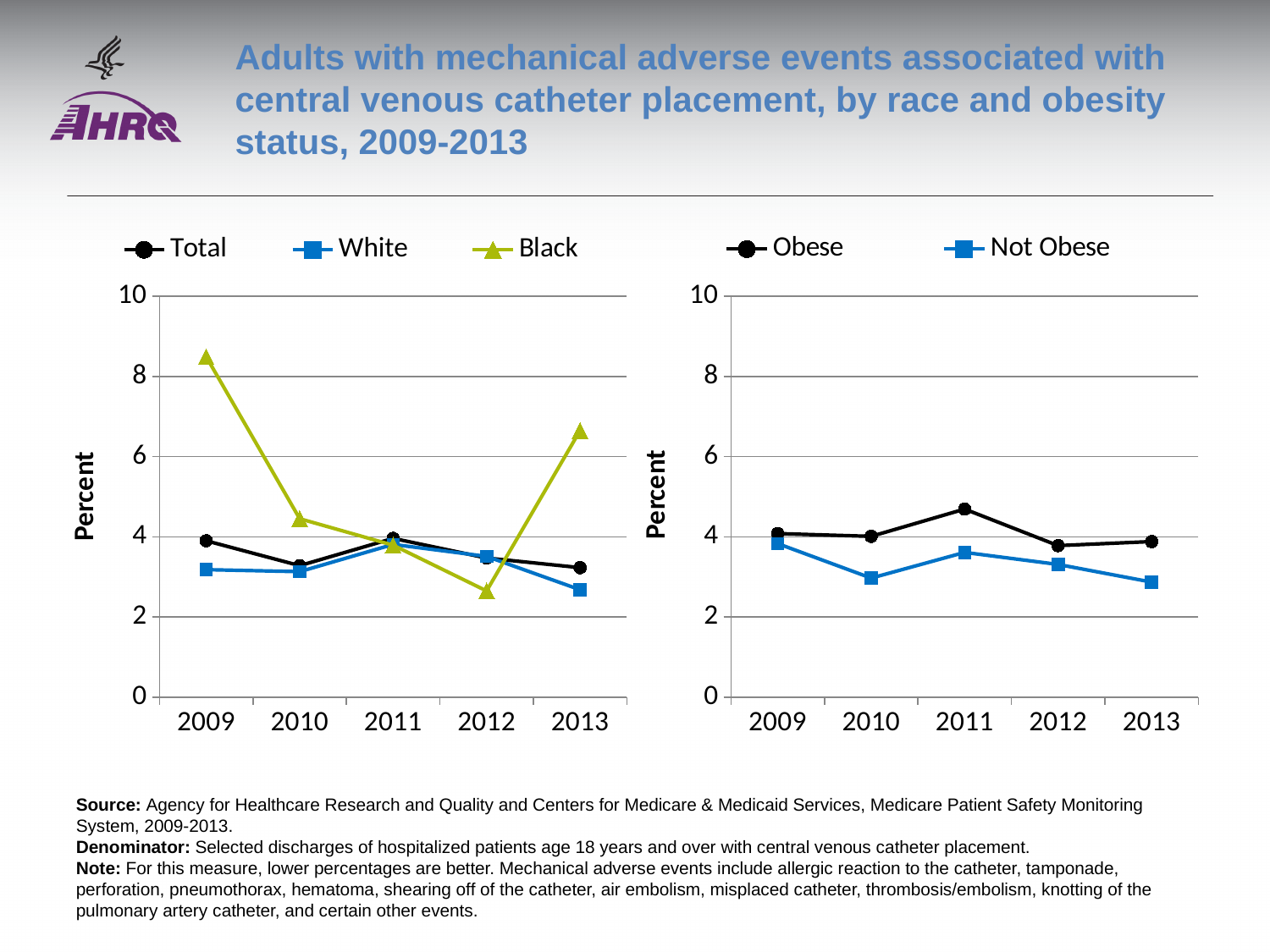
How many years are shown on the x axis of the left chart? 5 In the left chart, which is larger in 2009, Black or Total? Black How many series does the legend of the right chart (Obese, Not Obese) list? 2 In the left chart, in which year is the Black series highest? 2009 In the left chart, in which year is the Black series lowest? 2012 How many series does the legend of the left chart list? 3 In the left chart, is the value for Black in 2009 greater or less than 8? greater In the right chart, is the value for Obese in 2011 greater or less than 4? greater What kind of chart is the left chart (Total, White, Black)? line chart In the right chart, in which year is the Obese series highest? 2011 In the left chart, is the value for Black in 2012 greater or less than 4? less In the right chart, which is larger in 2011, Obese or Not Obese? Obese